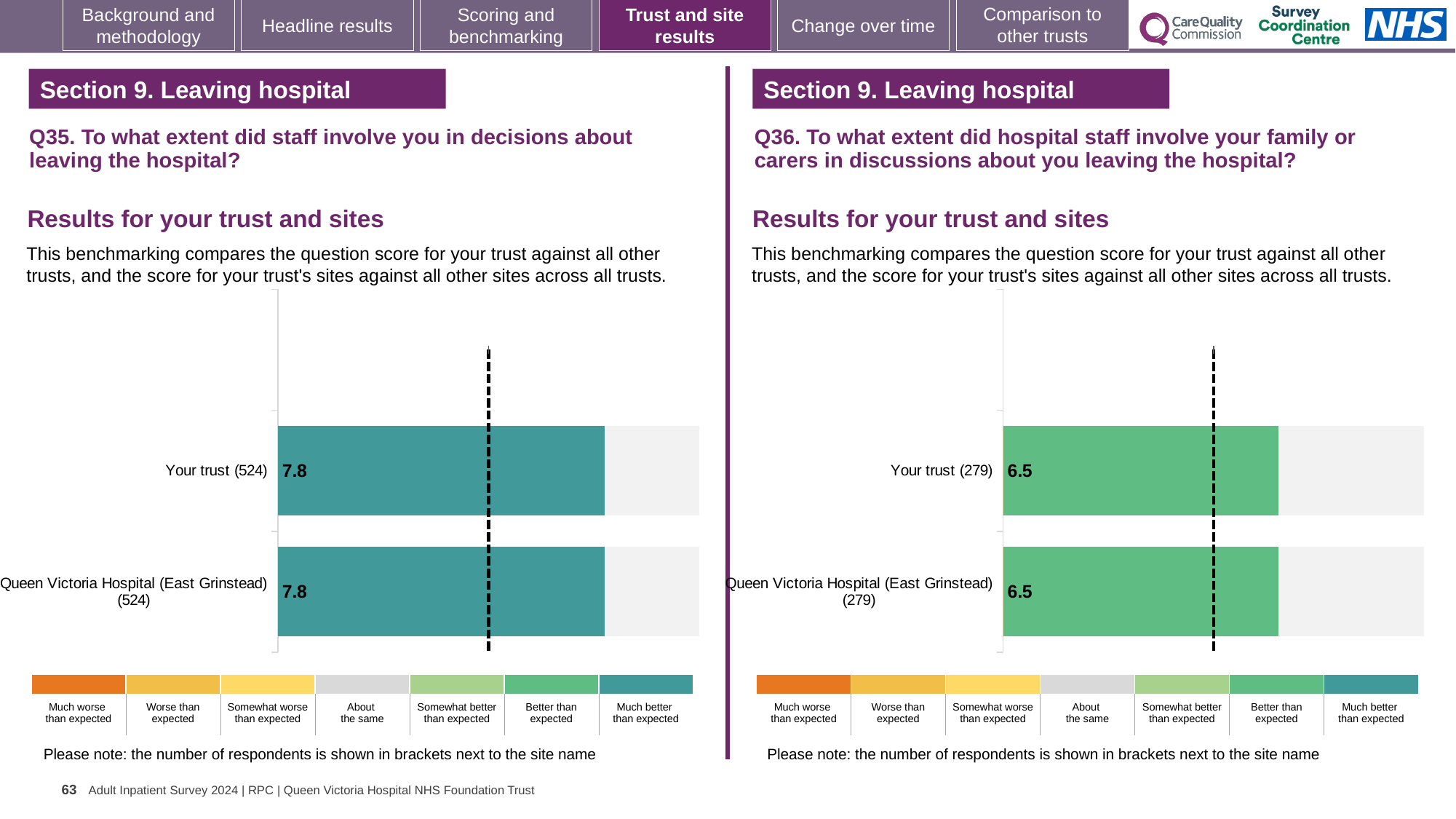
Which is larger: the Your trust score on the left chart (Q35) or the Your trust score on the right chart (Q36)? Left chart (Q35), 7.8 On the right chart (Q36), what is the score for Queen Victoria Hospital (East Grinstead)? 6.5 On the left chart (Q35), what is the score for Your trust? 7.8 What kind of chart is used on the left (Q35)? Bar chart On the right chart (Q36), how many bars are plotted? 2 On the left chart (Q35), what is the score for Queen Victoria Hospital (East Grinstead)? 7.8 On the right chart (Q36), what is the difference between the score for Your trust and the score for Queen Victoria Hospital (East Grinstead)? 0.0 On the right chart (Q36), what is the score for Your trust? 6.5 On the left chart (Q35), how many bars are plotted? 2 On the left chart (Q35), how many respondents are shown in brackets for Your trust? 524 On the right chart (Q36), which benchmark category does the bar colour correspond to in the legend? Better than expected On the left chart (Q35), what is the difference between the score for Your trust and the score for Queen Victoria Hospital (East Grinstead)? 0.0